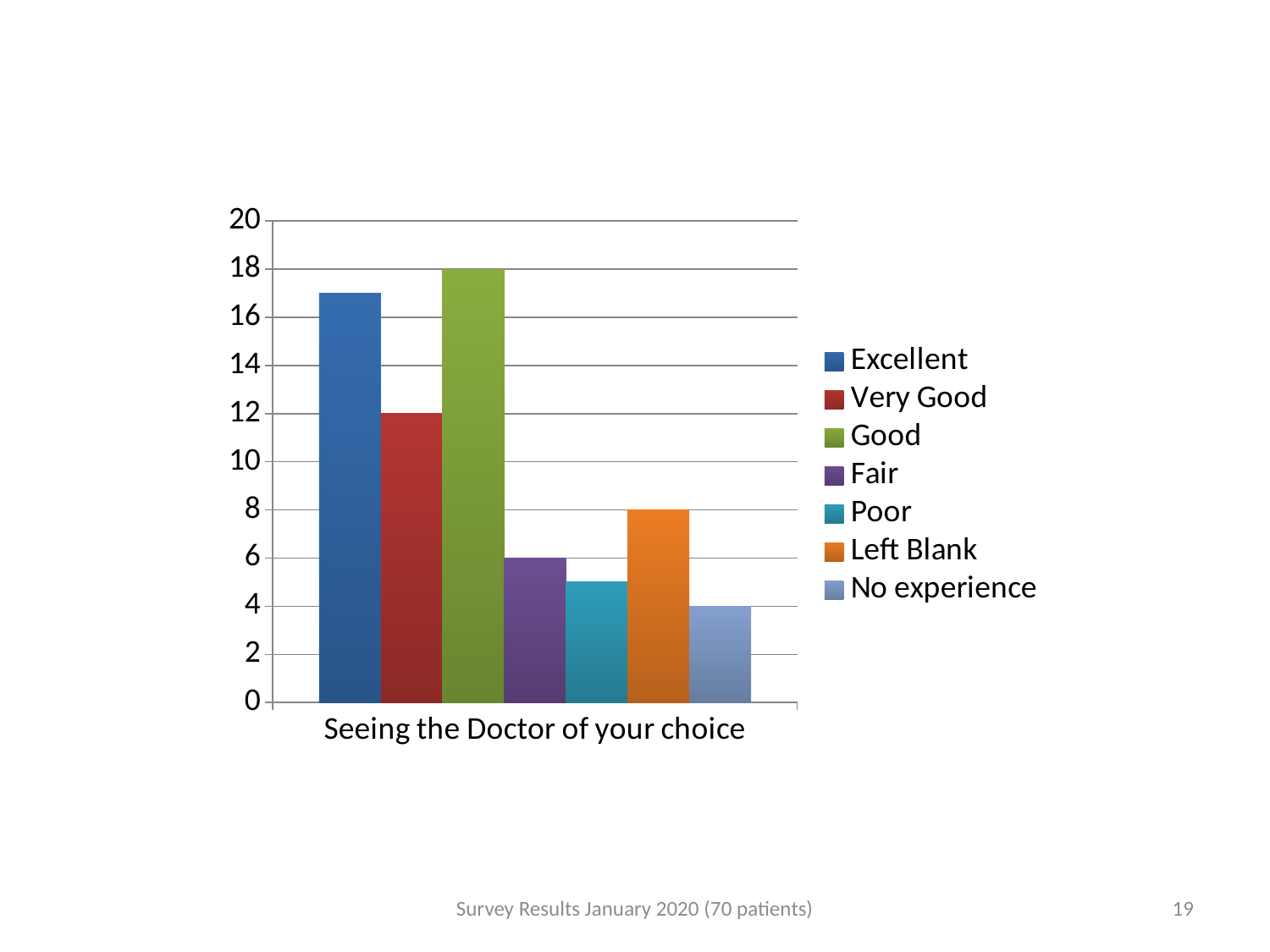
What is the value for Left Blank? 8 What type of chart is shown on the slide? Bar chart Is the value for Excellent greater or less than 16? greater How many series does the legend list? 7 Which series has the highest value? Good What is the value for No experience? 4 What is the difference between the values for Good and Very Good? 6 Which is larger, the value for Very Good or the value for Left Blank? Very Good What is the value for Good? 18 Is the value for Poor greater or less than 6? less What is the category label shown on the x axis? Seeing the Doctor of your choice What is the value for Very Good? 12